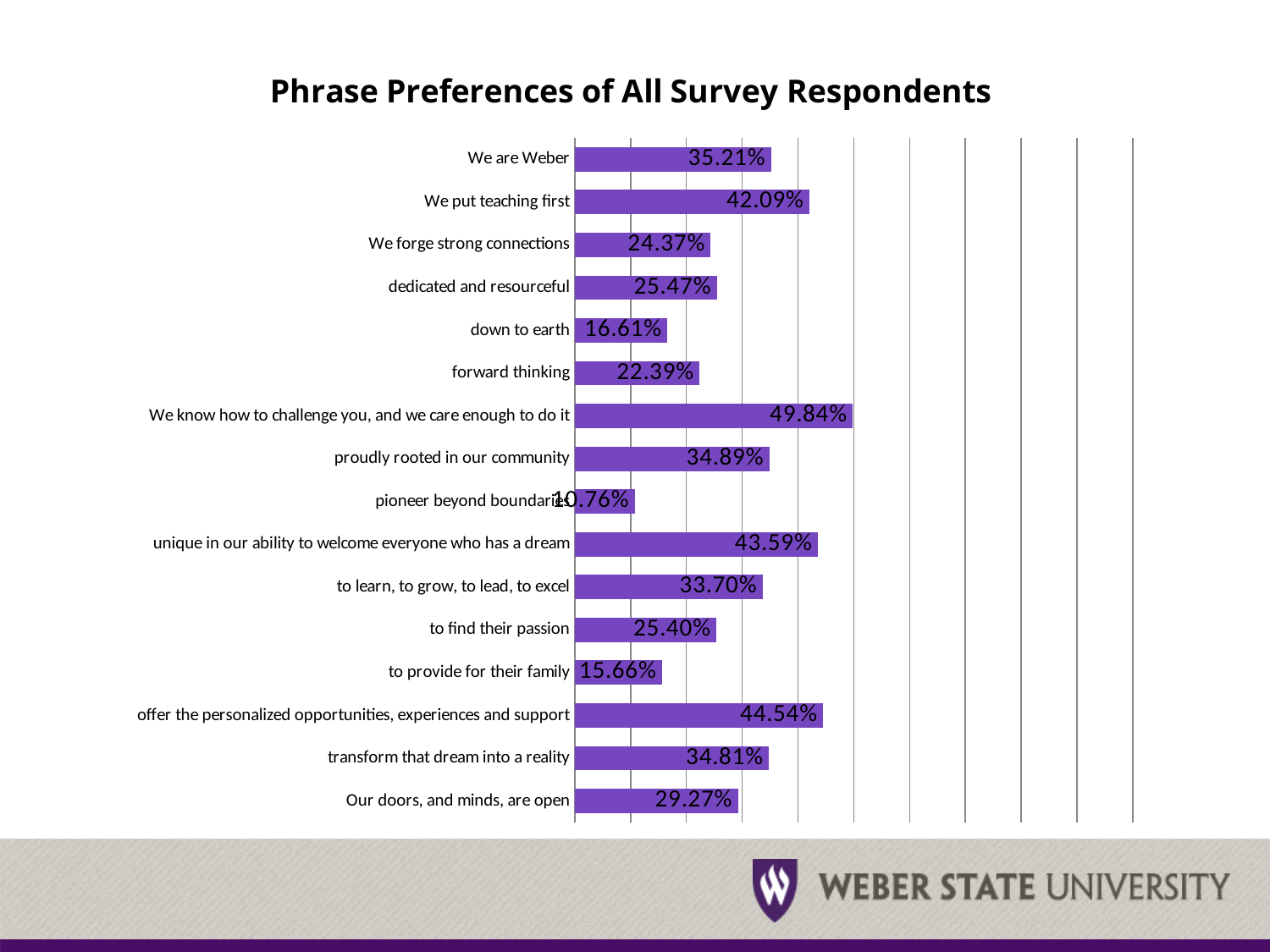
Which has a larger value, "forward thinking" or "We forge strong connections"? We forge strong connections What is the value for "We put teaching first"? 42.09% What is the difference between the values for "We know how to challenge you, and we care enough to do it" and "offer the personalized opportunities, experiences and support"? 5.30 percentage points What is the difference between the values for "We put teaching first" and "We are Weber"? 6.88 percentage points What is the value for "Our doors, and minds, are open"? 29.27% What type of chart is shown on the slide? Bar chart Which phrase has the highest preference value? We know how to challenge you, and we care enough to do it What percentage of respondents preferred the phrase "down to earth"? 16.61% How many phrases are plotted in the chart? 16 Which has a larger value, "to learn, to grow, to lead, to excel" or "to provide for their family"? to learn, to grow, to lead, to excel Which phrase has the lowest preference value? pioneer beyond boundaries What is the value shown for "offer the personalized opportunities, experiences and support"? 44.54%